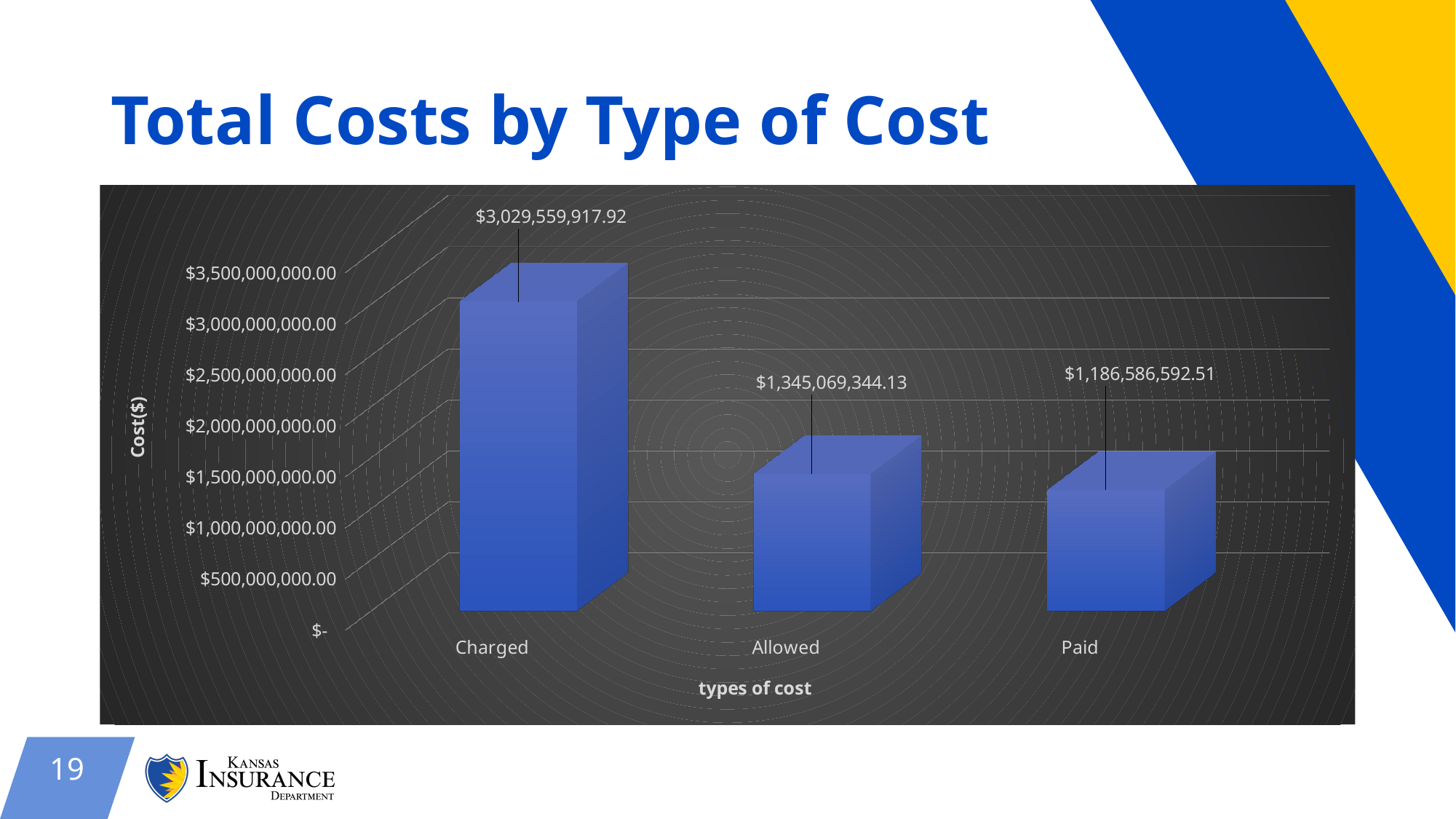
What is the value for Allowed? $1,345,069,344.13 What kind of chart is shown on the slide? Bar chart What is the value for Paid? $1,186,586,592.51 How many types of cost are shown on the chart? 3 What is the value for Charged? $3,029,559,917.92 Which is larger, the value for Allowed or the value for Paid? Allowed What is the label of the vertical axis? Cost($) What is the difference between the Allowed and Paid values? $158,482,751.62 Is the value for Paid greater or less than $1,500,000,000.00? less Which type of cost has the highest total cost? Charged Which type of cost has the lowest total cost? Paid What is the difference between the Charged and Allowed values? $1,684,490,573.79